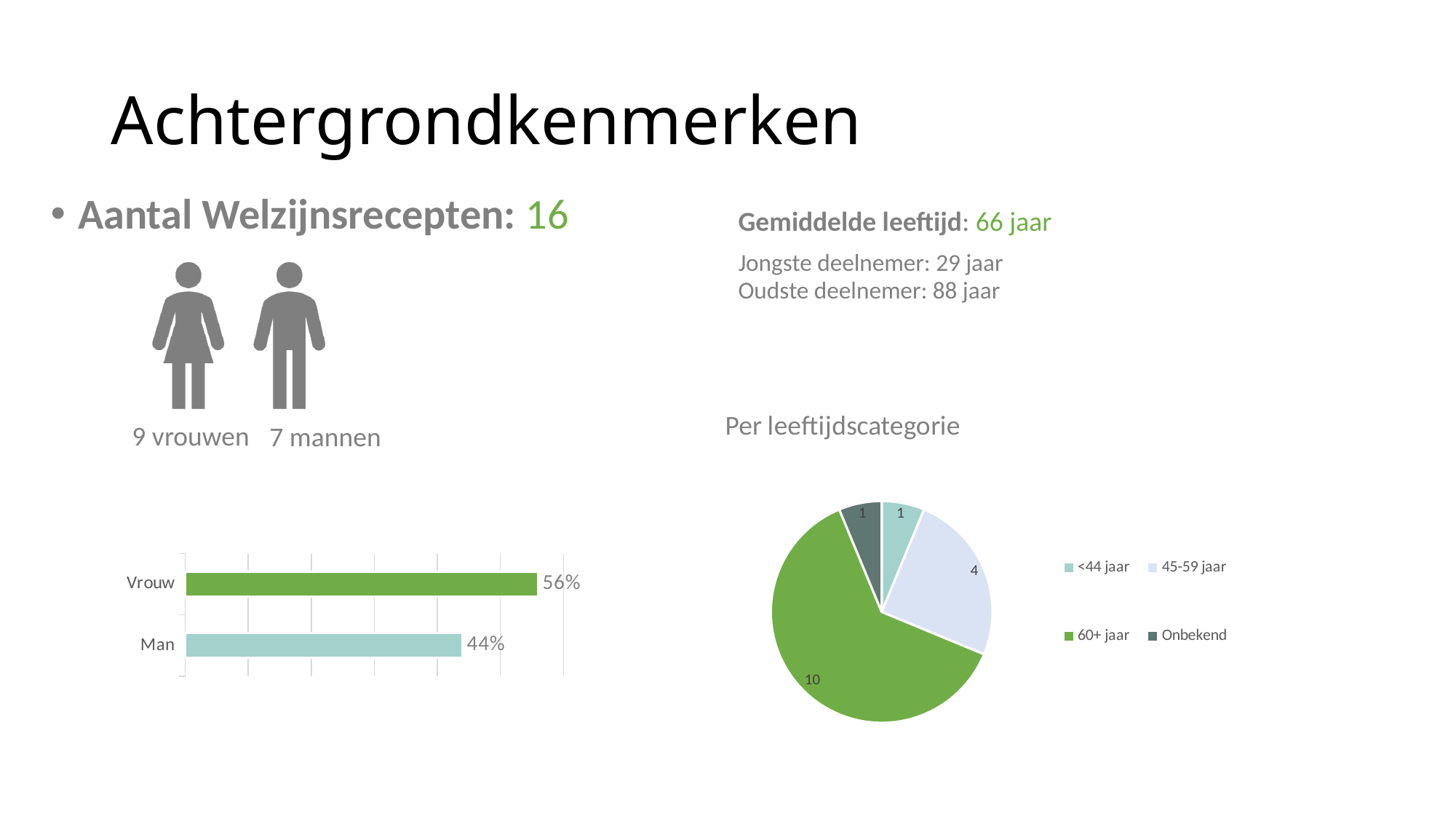
In the bar chart on the left, what is the value for Vrouw? 56% In the pie chart 'Per leeftijdscategorie', how many categories does the legend list? 4 What is the title of the pie chart on the right? Per leeftijdscategorie In the pie chart 'Per leeftijdscategorie', which category has the largest slice? 60+ jaar In the pie chart 'Per leeftijdscategorie', what is the value for 45-59 jaar? 4 In the bar chart on the left, what is the value for Man? 44% What kind of chart is the chart on the left showing Vrouw and Man? Bar chart In the bar chart on the left, which category has the larger value, Vrouw or Man? Vrouw In the bar chart on the left, what is the difference between the values for Vrouw and Man? 12% In the pie chart 'Per leeftijdscategorie', what is the value for 60+ jaar? 10 In the pie chart 'Per leeftijdscategorie', what is the total of all slices? 16 In the pie chart 'Per leeftijdscategorie', what share of the total does the 45-59 jaar slice represent? 25%